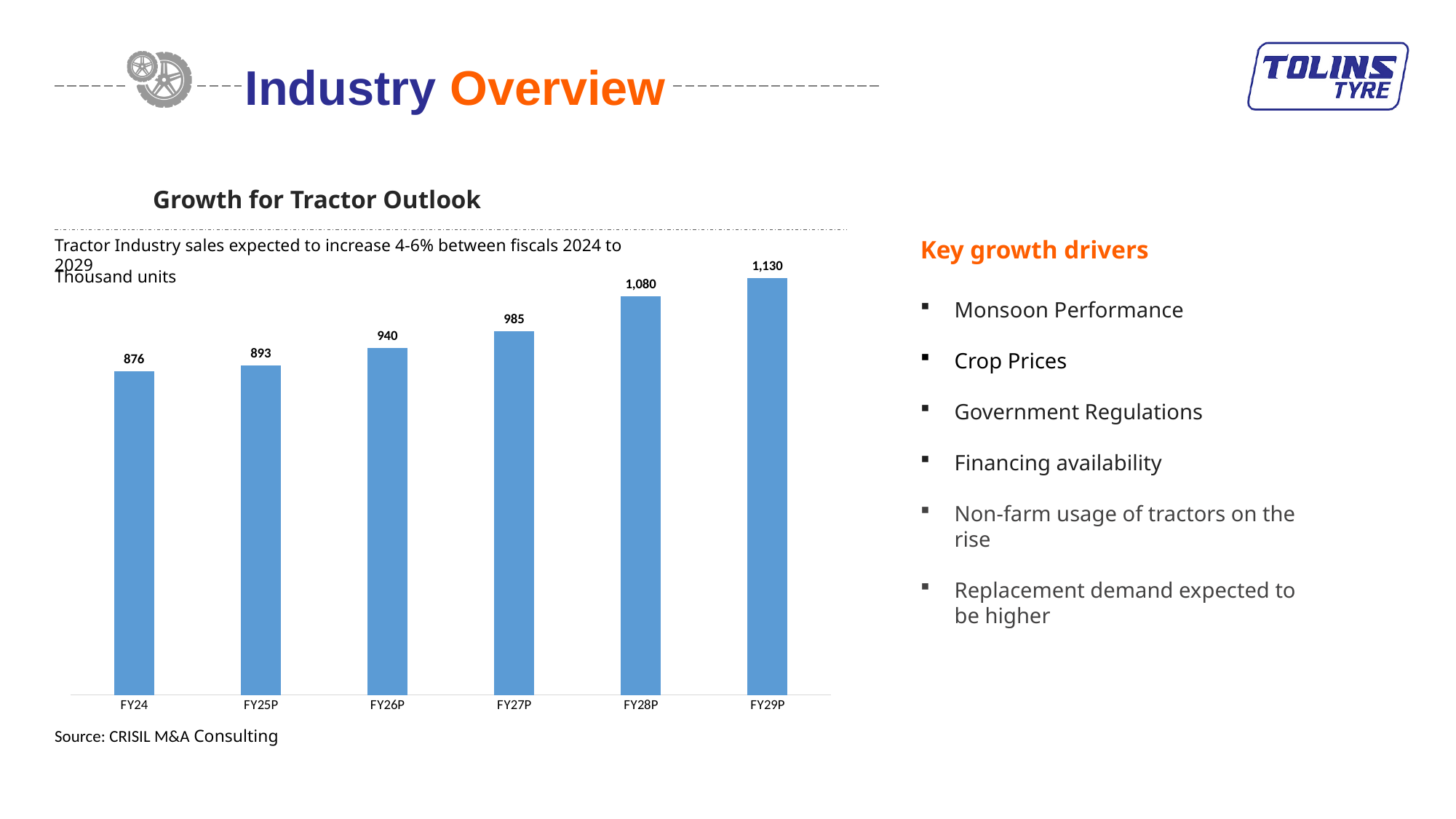
What is the value for FY24? 876 What is the difference between the values for FY28P and FY27P? 95 What is the title of the chart? Growth for Tractor Outlook Which fiscal year has the lowest value? FY24 How many fiscal years are shown on the chart? 6 What is the value for FY29P? 1,130 What kind of chart is shown? Bar chart Which is larger, the value for FY26P or the value for FY25P? FY26P What is the value for FY27P? 985 Which fiscal year has the highest value? FY29P What is the difference between the values for FY29P and FY24? 254 Do the values rise or fall from FY24 to FY29P? Rise